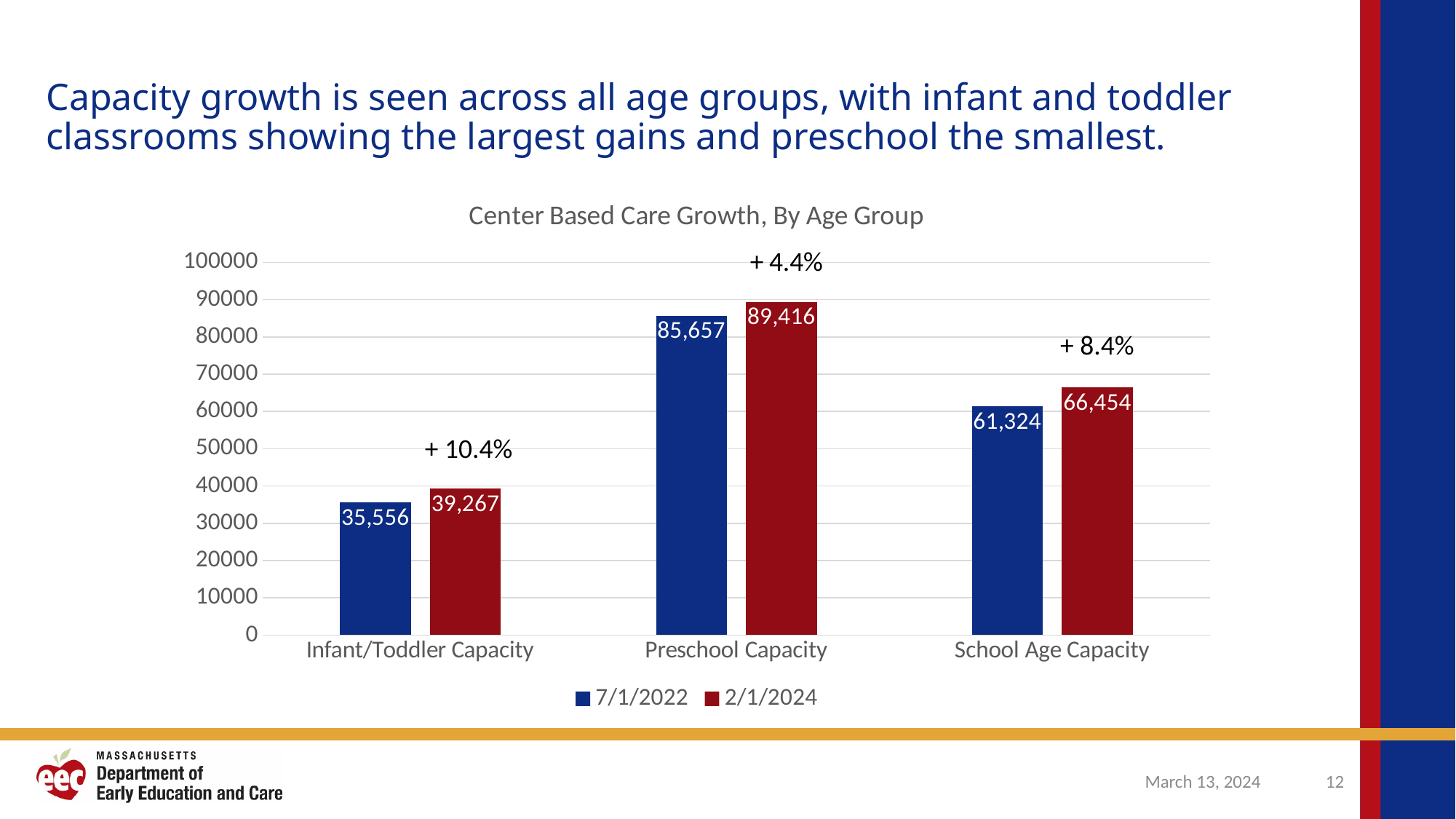
What kind of chart is shown on the slide? Bar chart What is the 2/1/2024 value for School Age Capacity? 66,454 How many age group categories are shown on the x axis? 3 What is the difference between the 2/1/2024 and 7/1/2022 values for School Age Capacity? 5,130 What is the 7/1/2022 value for Infant/Toddler Capacity? 35,556 What percentage growth is labelled above the Preschool Capacity bars? + 4.4% Which is larger: the 7/1/2022 value for Preschool Capacity or the 2/1/2024 value for School Age Capacity? 7/1/2022 value for Preschool Capacity Which age group has the highest 2/1/2024 capacity? Preschool Capacity What is the 2/1/2024 value for Preschool Capacity? 89,416 How many series does the legend list? 2 Which age group has the lowest 7/1/2022 capacity? Infant/Toddler Capacity What is the difference between the 2/1/2024 and 7/1/2022 values for Infant/Toddler Capacity? 3,711